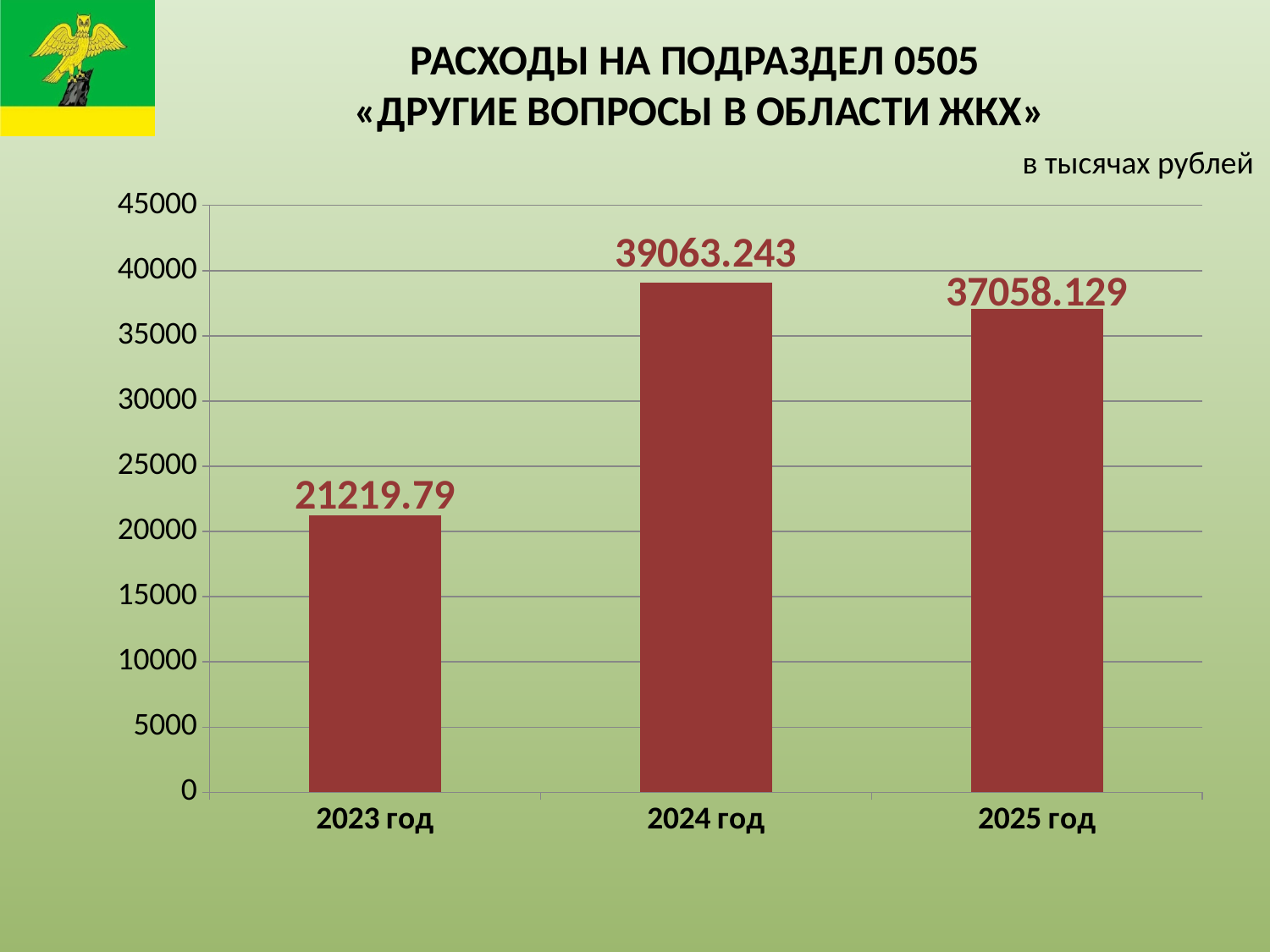
What is the difference between the values for 2024 год and 2025 год? 2005.114 What kind of chart is shown on the slide? bar chart Which is larger, the value for 2025 год or the value for 2023 год? 2025 год Which year has the highest value? 2024 год What is the difference between the values for 2024 год and 2023 год? 17843.453 How many years are shown on the chart? 3 What is the value for 2023 год? 21219.79 Is the value for 2023 год greater or less than 25000? less What is the value for 2024 год? 39063.243 In what units are the values on the chart expressed? в тысячах рублей What is the value for 2025 год? 37058.129 Which year has the lowest value? 2023 год